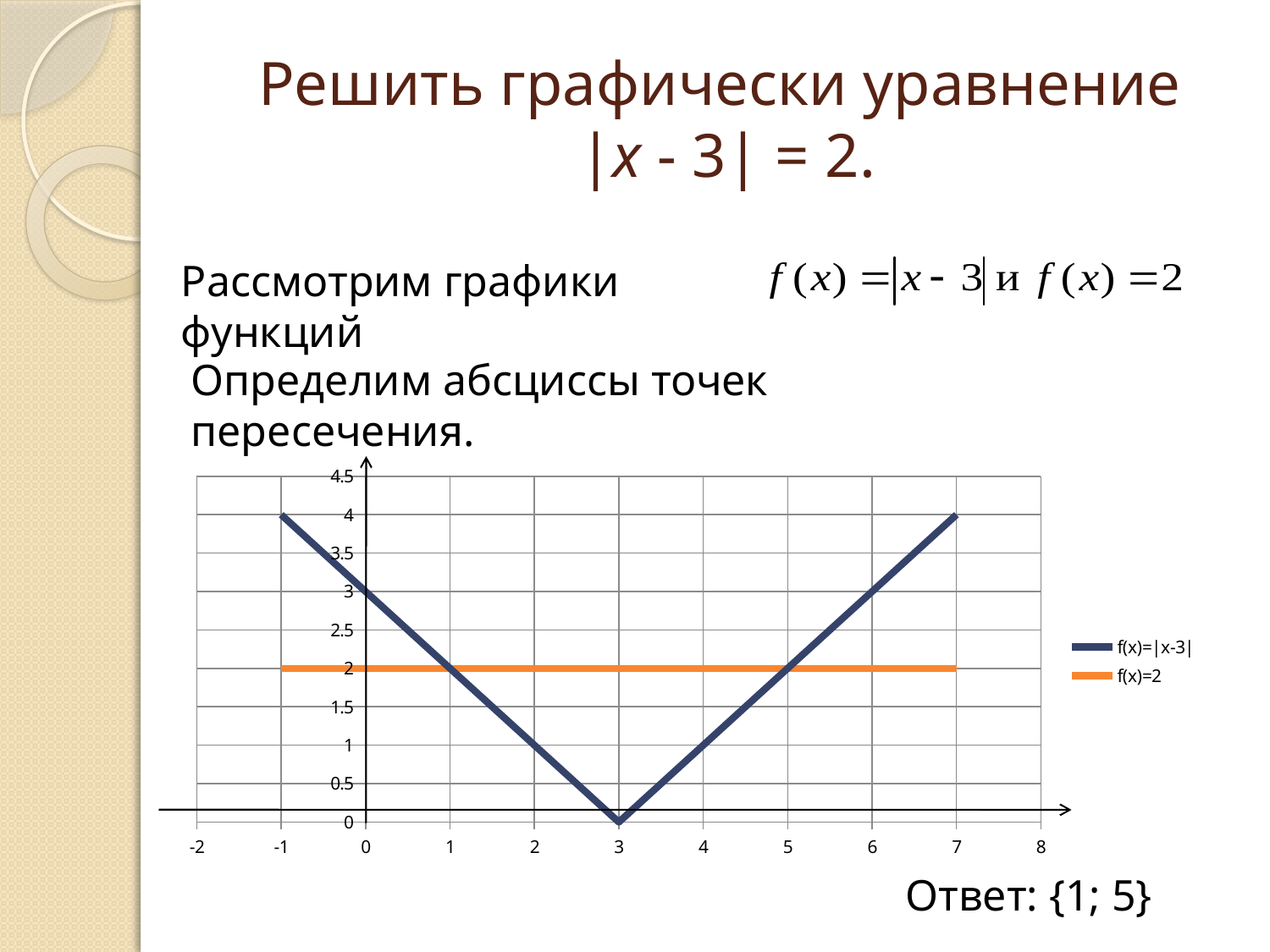
What is the value of f(x)=|x-3| at x = 7? 4 What is the value of f(x)=|x-3| at x = 0? 3 How many series does the legend list? 2 What kind of chart is shown on the slide? line chart Is the value of f(x)=|x-3| at x = 4 greater or less than 2? less What is the value of f(x)=|x-3| at x = 3? 0 Which is larger at x = 0: f(x)=|x-3| or f(x)=2? f(x)=|x-3| What are the two series named in the legend? f(x)=|x-3| and f(x)=2 At which x value does f(x)=|x-3| reach its lowest point? 3 What constant value does the f(x)=2 line take across the chart? 2 What is the value of f(x)=|x-3| at x = -1? 4 Does f(x)=|x-3| rise or fall as x increases from 3 to 7? rise